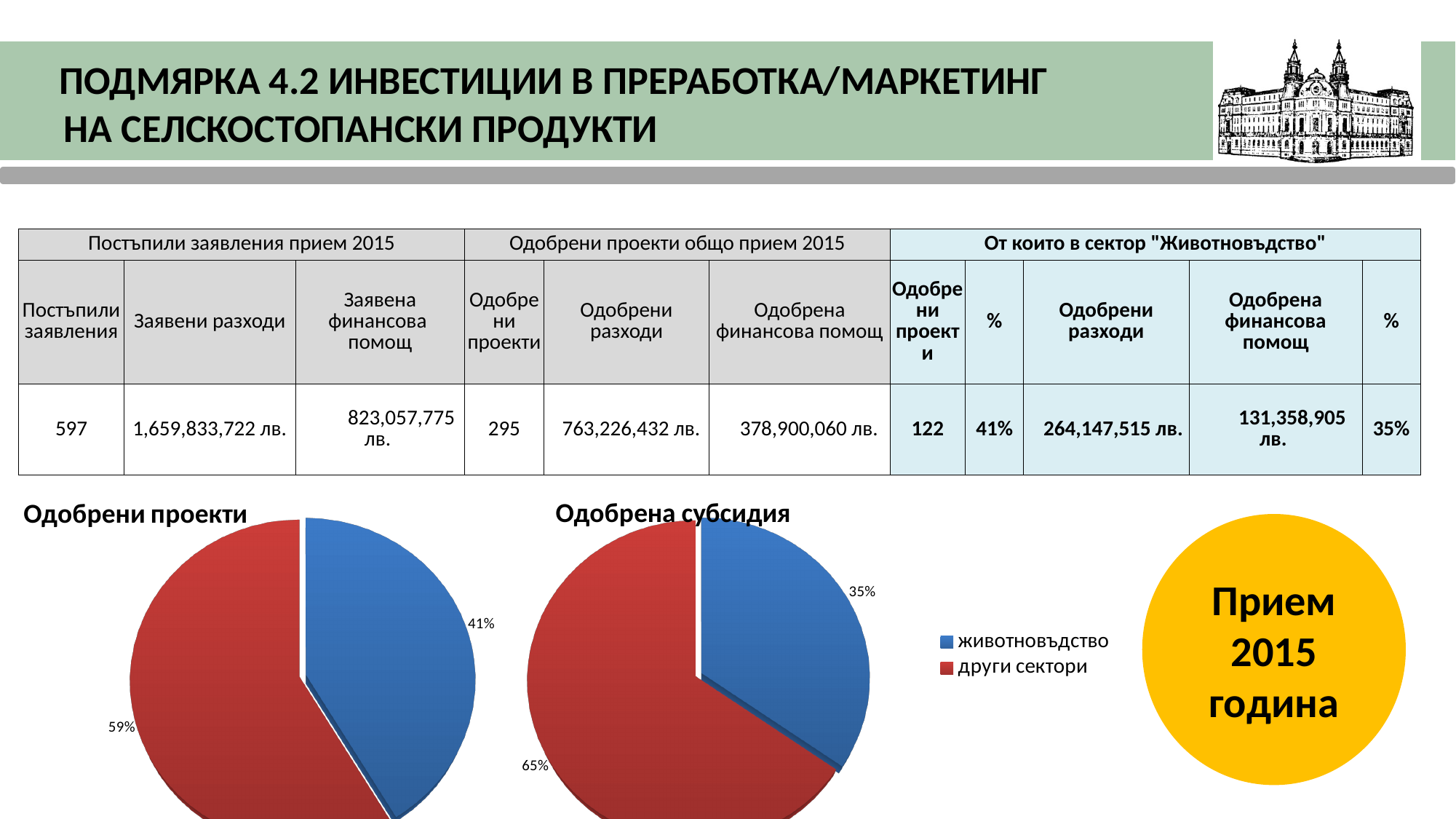
Which chart shows a larger share for "животновъдство": "Одобрени проекти" or "Одобрена субсидия"? Одобрени проекти How many slices does the "Одобрена субсидия" pie chart have? 2 In the "Одобрени проекти" chart, what is the difference between the "други сектори" share and the "животновъдство" share? 18% In the "Одобрена субсидия" chart, what share does "други сектори" have? 65% In the "Одобрена субсидия" chart, which slice is the smallest? животновъдство In the "Одобрени проекти" chart, which slice is the largest? други сектори What kind of chart is the "Одобрени проекти" chart? pie chart In the "Одобрена субсидия" chart, what share does "животновъдство" have? 35% Which colour represents "други сектори" in the pie charts? red In the "Одобрени проекти" chart, what share does "животновъдство" have? 41% In the "Одобрена субсидия" chart, what is the difference between the "други сектори" share and the "животновъдство" share? 30%